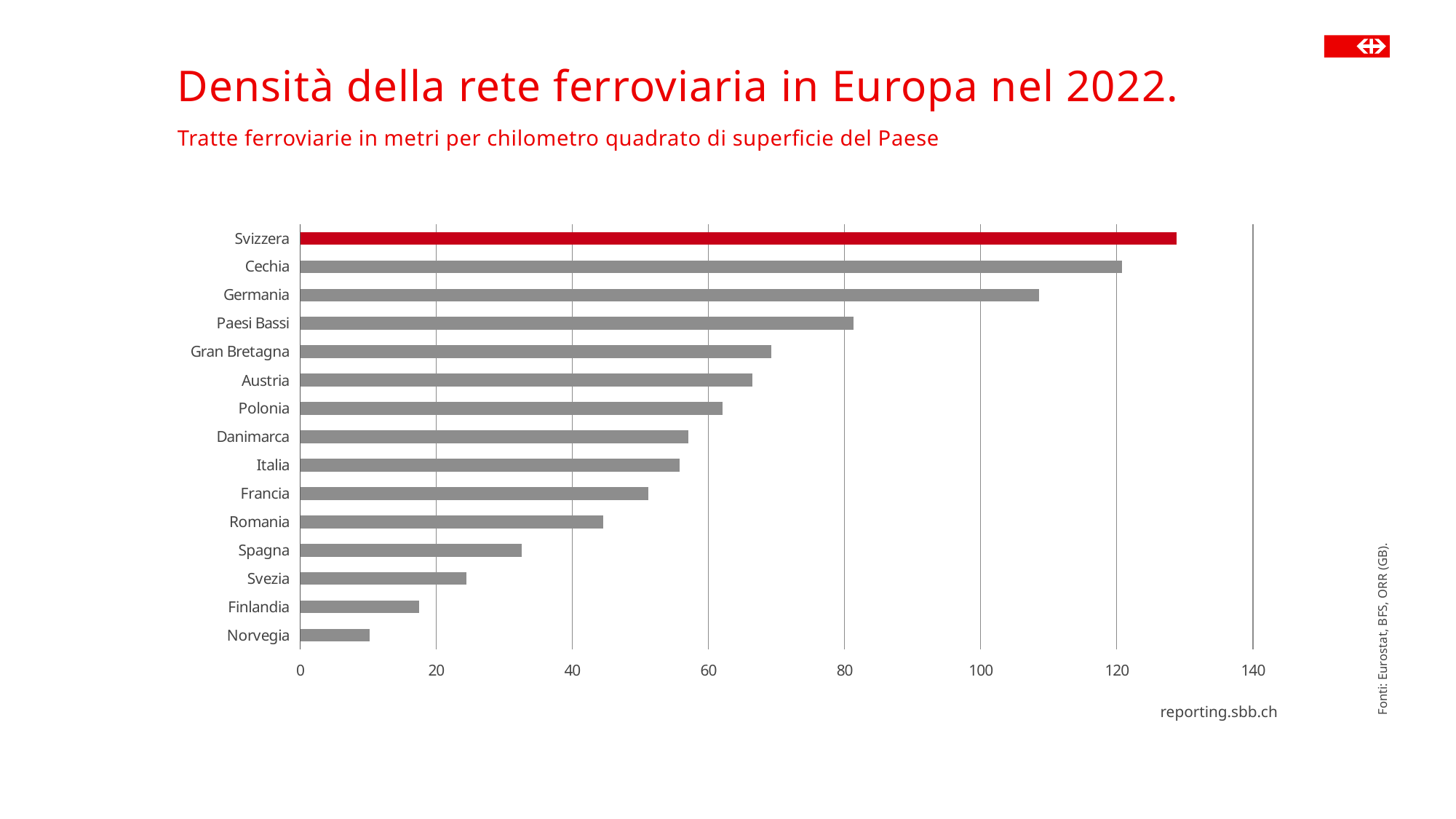
Is the value for Svizzera greater or less than 120? greater Which country's bar is highlighted in red? Svizzera Is the value for Germania greater or less than 100? greater Which country has the lowest rail network density in the chart? Norvegia What kind of chart is shown on the slide? bar chart Is the value for Paesi Bassi greater or less than 80? greater Which has a lower value, Finlandia or Svezia? Finlandia How many countries are shown in the chart? 15 Which has a higher value, Cechia or Germania? Cechia Which country has the highest rail network density in the chart? Svizzera